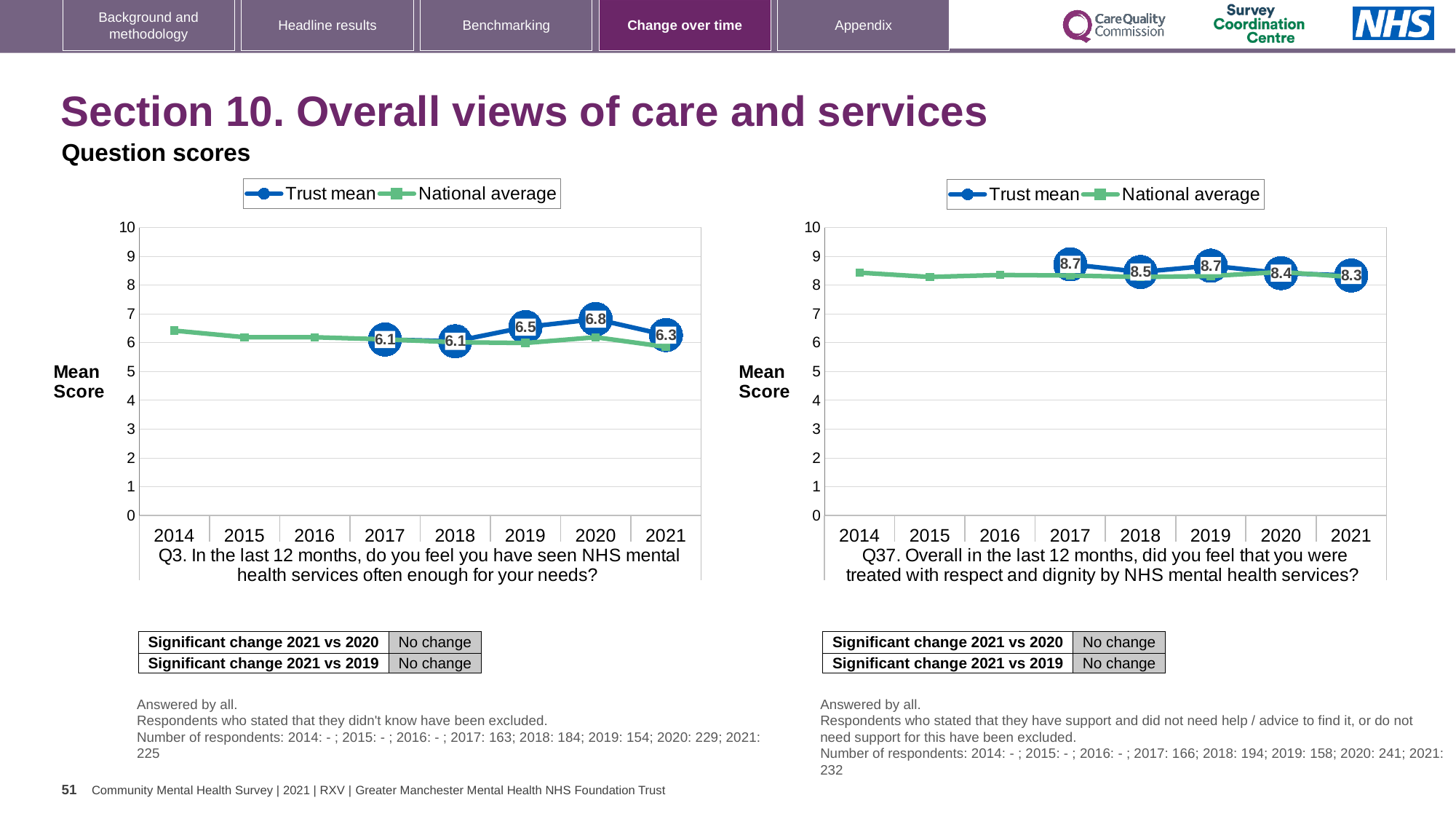
In the Q3 chart on the left, which year has the highest Trust mean score? 2020 In the Q3 chart on the left, what is the Trust mean score for 2021? 6.3 In the Q37 chart on the right, what is the Trust mean score for 2021? 8.3 What kind of chart is the Q3 chart on the left? Line chart In the Q3 chart on the left, is the Trust mean score higher in 2019 or in 2021? 2019 How many series does the legend of the Q37 chart on the right list? 2 In the Q37 chart on the right, what is the difference between the Trust mean scores for 2017 and 2020? 0.3 In the Q37 chart on the right, which year has the lowest Trust mean score? 2021 In the Q37 chart on the right, what is the Trust mean score for 2018? 8.5 In the Q3 chart on the left, what is the difference between the Trust mean scores for 2020 and 2021? 0.5 In the Q3 chart on the left, what is the Trust mean score for 2020? 6.8 In the Q3 chart on the left, is the National average for 2014 greater or less than 6? greater